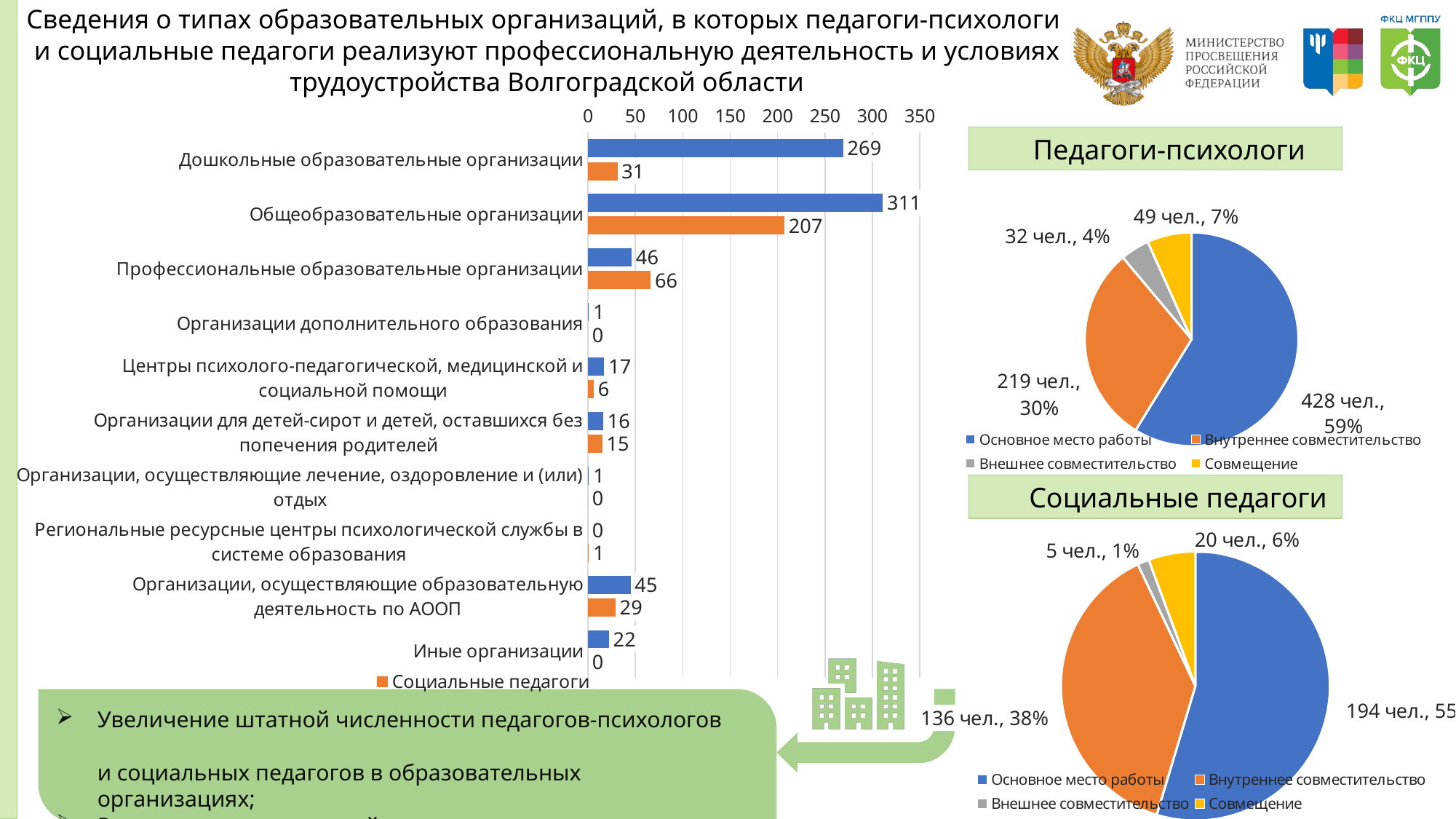
How many entries does the legend of the pie chart titled Социальные педагоги list? 4 In the pie chart titled Социальные педагоги, what is the value for Внешнее совместительство? 5 чел., 1% In the pie chart titled Педагоги-психологи, what share does Внутреннее совместительство have? 30% On the bar chart on the left, what is the difference between the blue bar and the orange bar for Дошкольные образовательные организации? 238 On the bar chart on the left, how many categories are shown on the vertical axis? 10 On the bar chart on the left, what is the value for Социальные педагоги in Профессиональные образовательные организации? 66 What type of chart is the chart on the left of the slide? bar chart On the bar chart on the left, what is the value for Социальные педагоги in Общеобразовательные организации? 207 In the pie chart titled Педагоги-психологи, what is the value for Основное место работы? 428 чел., 59% On the bar chart on the left, what is the value of the blue bar for Дошкольные образовательные организации? 269 On the bar chart on the left, which category has the highest value for Социальные педагоги? Общеобразовательные организации On the bar chart on the left, which is larger for Профессиональные образовательные организации: the blue bar or the orange bar (Социальные педагоги)? the orange bar (Социальные педагоги)